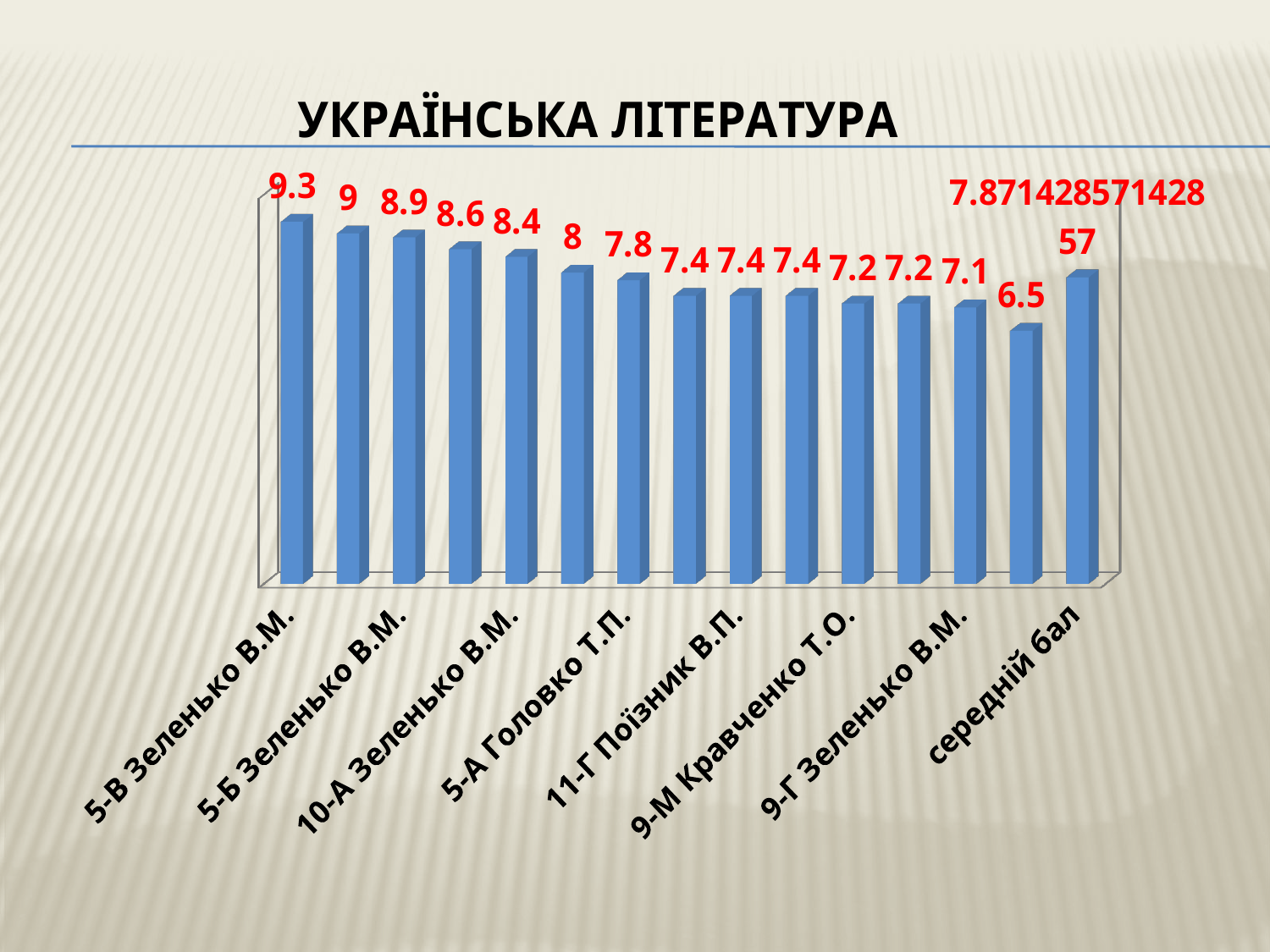
What is the title of the chart? УКРАЇНСЬКА ЛІТЕРАТУРА What type of chart is shown on the slide? bar chart What is the difference between the values for 5-В Зеленько В.М. and 9-Г Зеленько В.М.? 2.2 What is the value for 5-А Головко Т.П.? 7.8 What is the value for 9-Г Зеленько В.М.? 7.1 Which is larger, the value for 5-Б Зеленько В.М. or the value for 9-М Кравченко Т.О.? 5-Б Зеленько В.М. What is the value for 9-М Кравченко Т.О.? 7.2 What is the value for 10-А Зеленько В.М.? 8.4 What is the value for 5-В Зеленько В.М.? 9.3 How many bars are plotted in the chart? 15 Which labelled category has the highest value? 5-В Зеленько В.М. What is the value for 5-Б Зеленько В.М.? 8.9